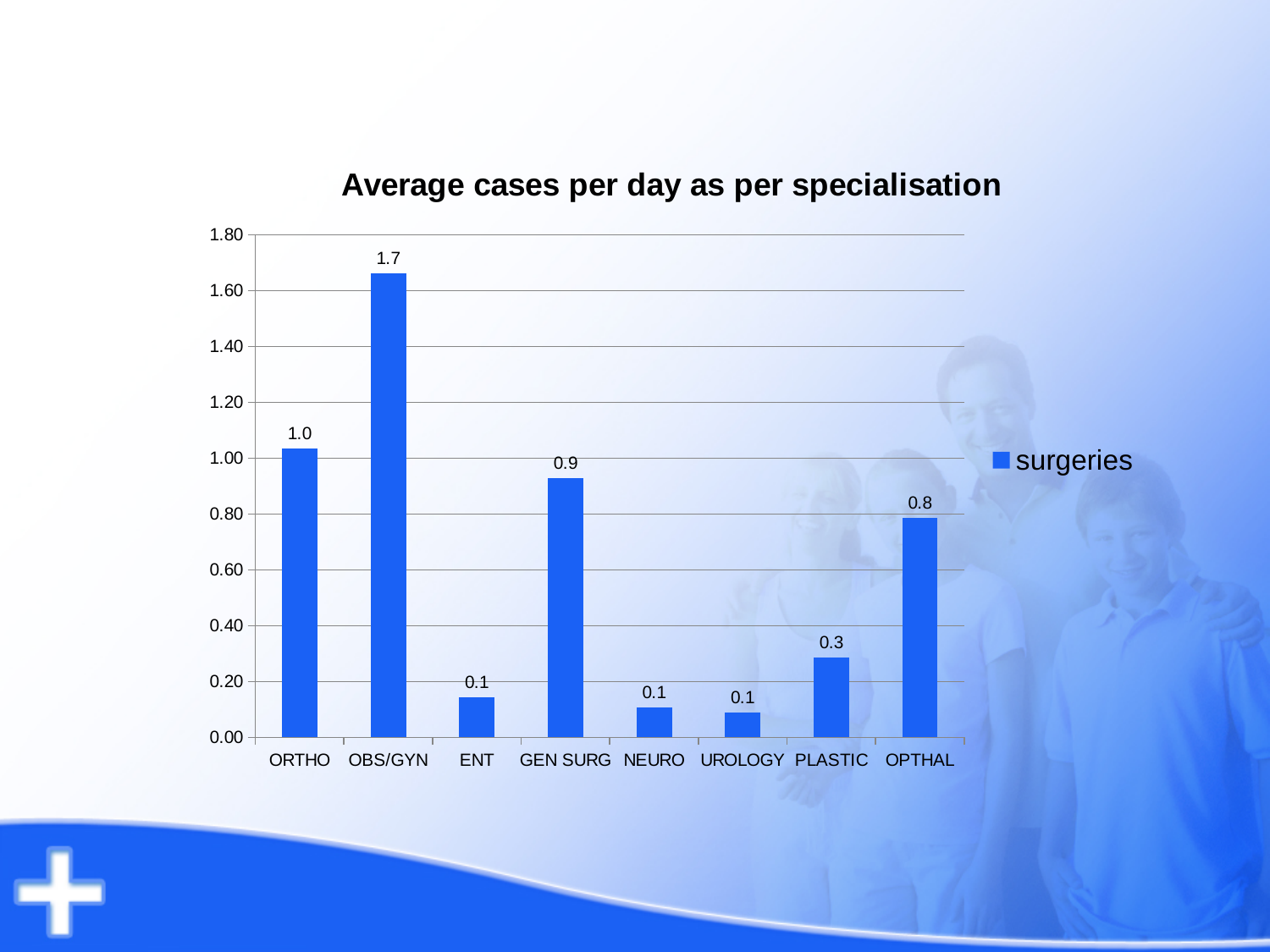
What is the value for PLASTIC? 0.3 Which is larger, the value for GEN SURG or the value for OPTHAL? GEN SURG Which specialisation has the highest average cases per day? OBS/GYN What is the value for OBS/GYN? 1.7 Is the value for OBS/GYN greater or less than 1.60? greater What kind of chart is shown on the slide? Bar chart What is the value for GEN SURG? 0.9 How many series does the legend list? 1 How many specialisations are shown on the x axis? 8 Is the value for PLASTIC greater or less than 0.20? greater What is the difference between the values for OBS/GYN and ORTHO? 0.7 What is the value for OPTHAL? 0.8